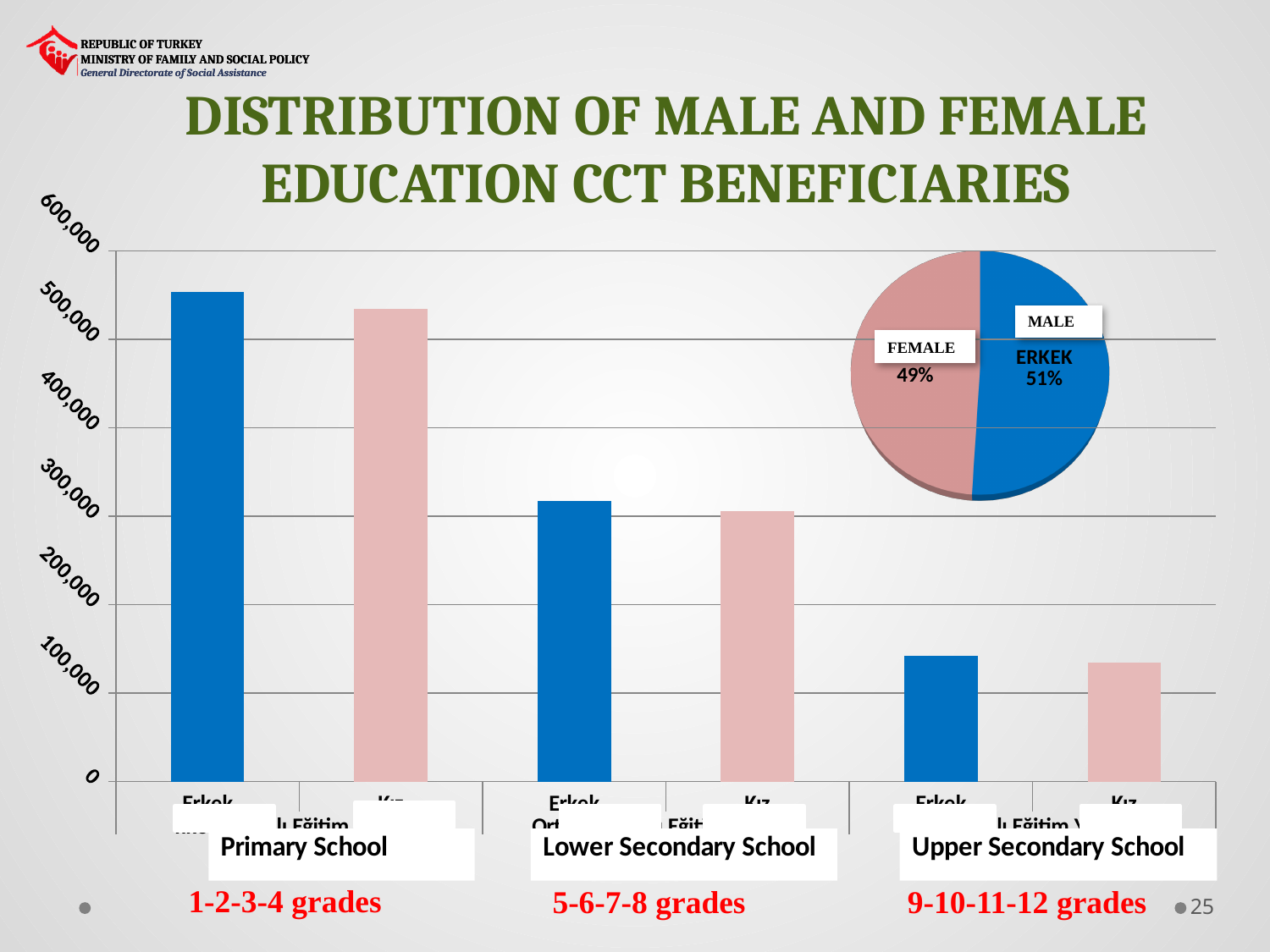
In the pie chart, what share of education CCT beneficiaries is male (ERKEK)? 51% In the bar chart, is the value for male (Erkek) beneficiaries in Upper Secondary School greater or less than 200,000? less In the bar chart, is the value for male (Erkek) beneficiaries in Primary School greater or less than 500,000? greater In the bar chart, do the values rise or fall from Primary School to Upper Secondary School? Fall In the bar chart, which is larger: the female (Kız) value for Primary School or the male (Erkek) value for Lower Secondary School? Primary School female (Kız) In the bar chart, which school level has the shortest bars? Upper Secondary School In the bar chart, which school level has the tallest bars? Primary School In the bar chart, is the value for male (Erkek) beneficiaries in Lower Secondary School greater or less than 300,000? greater In the pie chart, what share of education CCT beneficiaries is female? 49% What kind of chart is the large chart on the left of the slide? Bar chart How many school levels are shown in the bar chart? 3